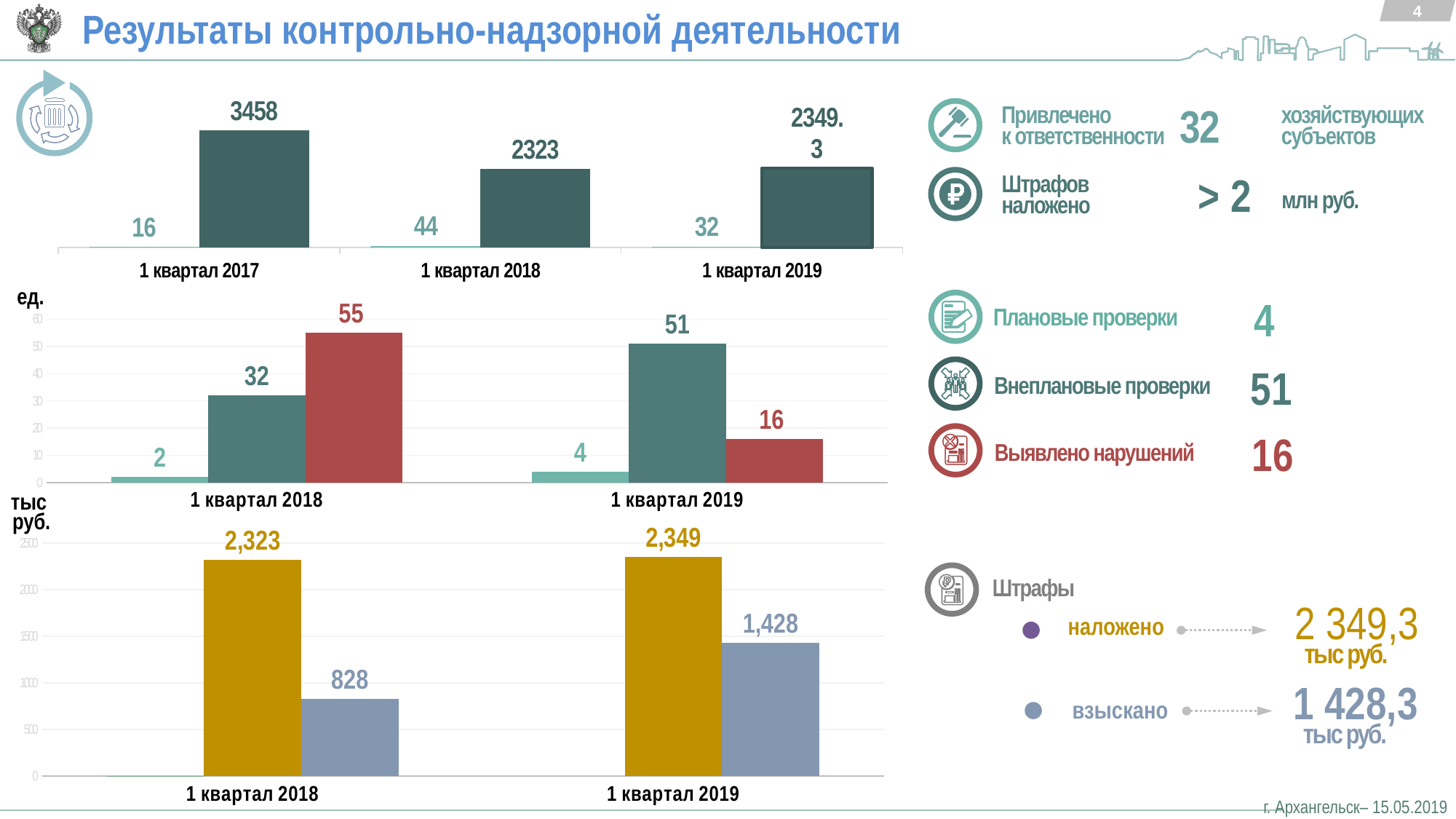
In the middle chart (ед.), what is the value of the red bar for 1 квартал 2018? 55 In the top chart, how many quarters are shown on the x axis? 3 In the middle chart (ед.), what is the value of the dark teal bar for 1 квартал 2019? 51 In the top chart, which quarter has the highest value for the tall dark bar? 1 квартал 2017 In the top chart, what is the small value shown for 1 квартал 2018? 44 In the top chart, what is the value of the tall dark bar for 1 квартал 2017? 3458 In the bottom chart (тыс руб.), what is the difference between the yellow bar values for 1 квартал 2019 and 1 квартал 2018? 26 What kind of chart is the bottom chart (тыс руб.)? bar chart In the bottom chart (тыс руб.), what is the value of the blue-grey bar for 1 квартал 2018? 828 In the top chart, what is the value of the tall dark bar for 1 квартал 2018? 2323 In the middle chart (ед.), what is the difference between the red bar values for 1 квартал 2018 and 1 квартал 2019? 39 In the middle chart (ед.), which is larger for 1 квартал 2019: the dark teal bar or the red bar? the dark teal bar